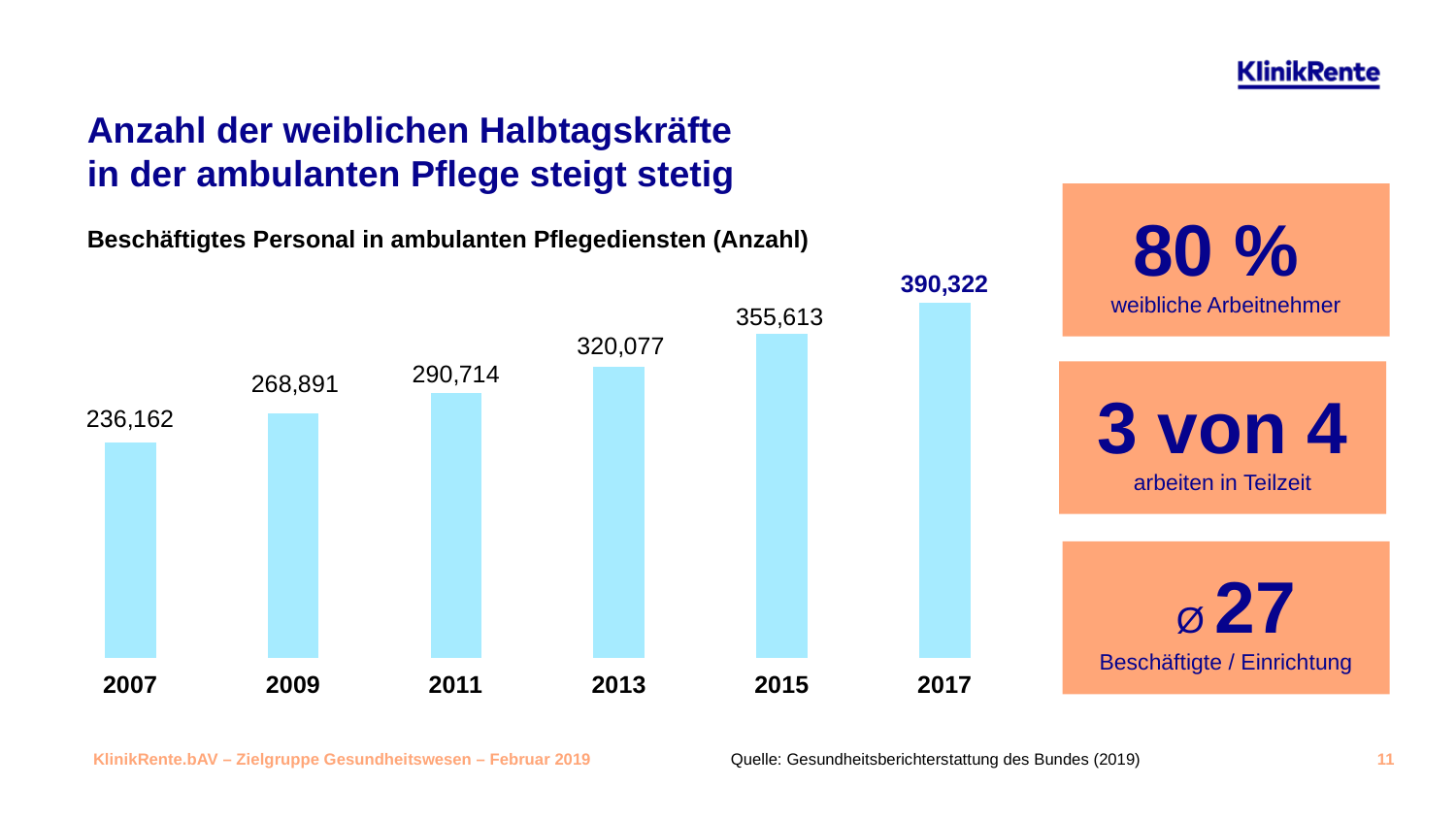
Which is larger, the value for 2011 or the value for 2009? 2011 Which year has the highest value? 2017 Do the values rise or fall from 2007 to 2017? rise Which year has the lowest value? 2007 What is the value shown for 2007? 236,162 How many years are shown on the x axis? 6 What kind of chart is shown? bar chart What is the value shown for 2017? 390,322 What is the difference between the values for 2017 and 2007? 154,160 What is the title of the chart? Beschäftigtes Personal in ambulanten Pflegediensten (Anzahl) What is the value shown for 2013? 320,077 What is the difference between the values for 2015 and 2013? 35,536